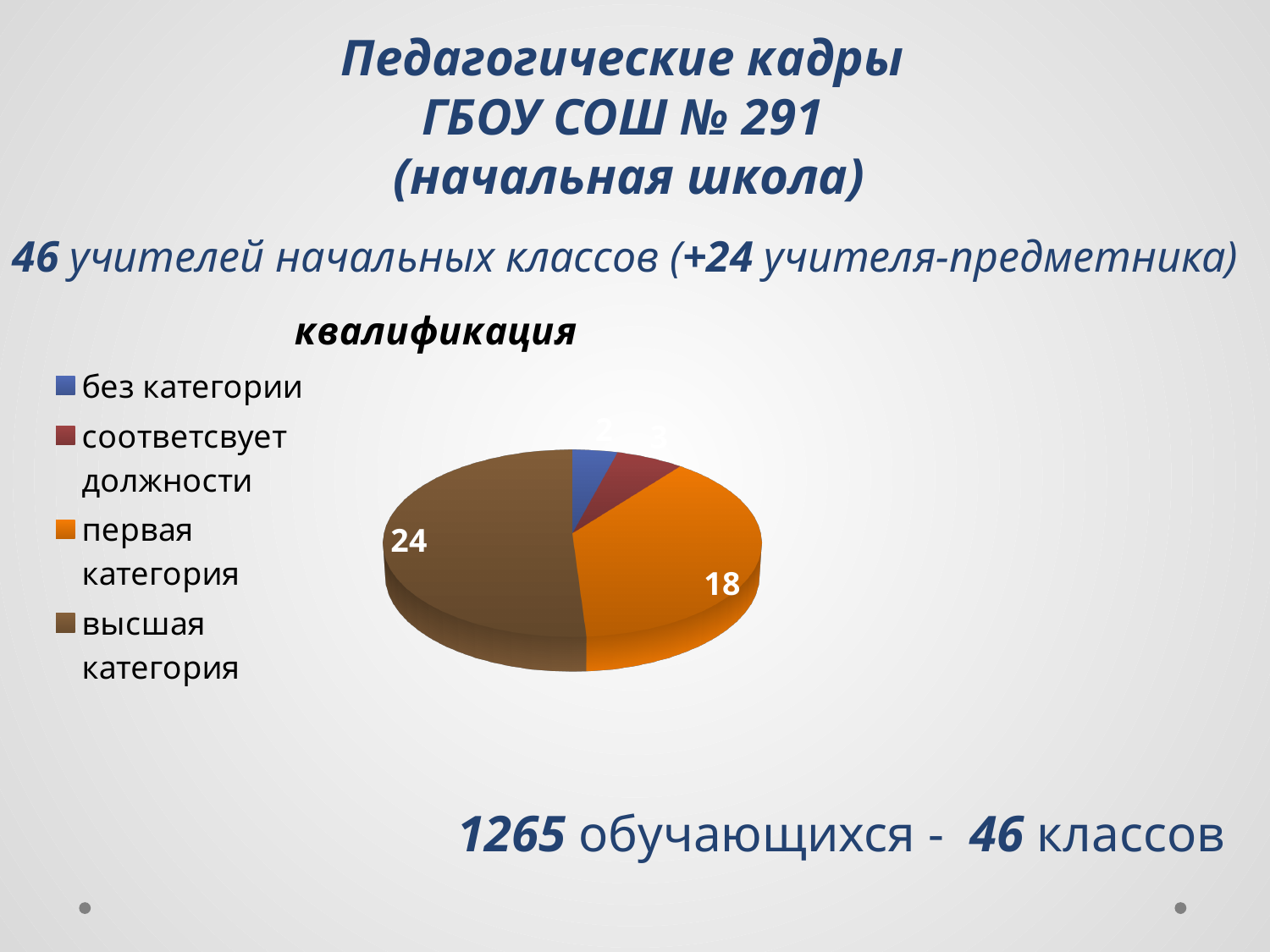
What colour is the slice for "высшая категория" in the pie chart? brown Which category has the smallest slice in the pie chart? без категории What kind of chart is shown under the heading "квалификация"? pie chart What is the difference between the values for "высшая категория" and "первая категория"? 6 What is the title of the pie chart? квалификация How many categories does the pie chart have? 4 Which category has the largest slice in the pie chart? высшая категория Which is larger in the pie chart: "без категории" or "первая категория"? первая категория Which is larger in the pie chart: "первая категория" or "высшая категория"? высшая категория What is the value for "первая категория" in the pie chart? 18 What is the value for "высшая категория" in the pie chart? 24